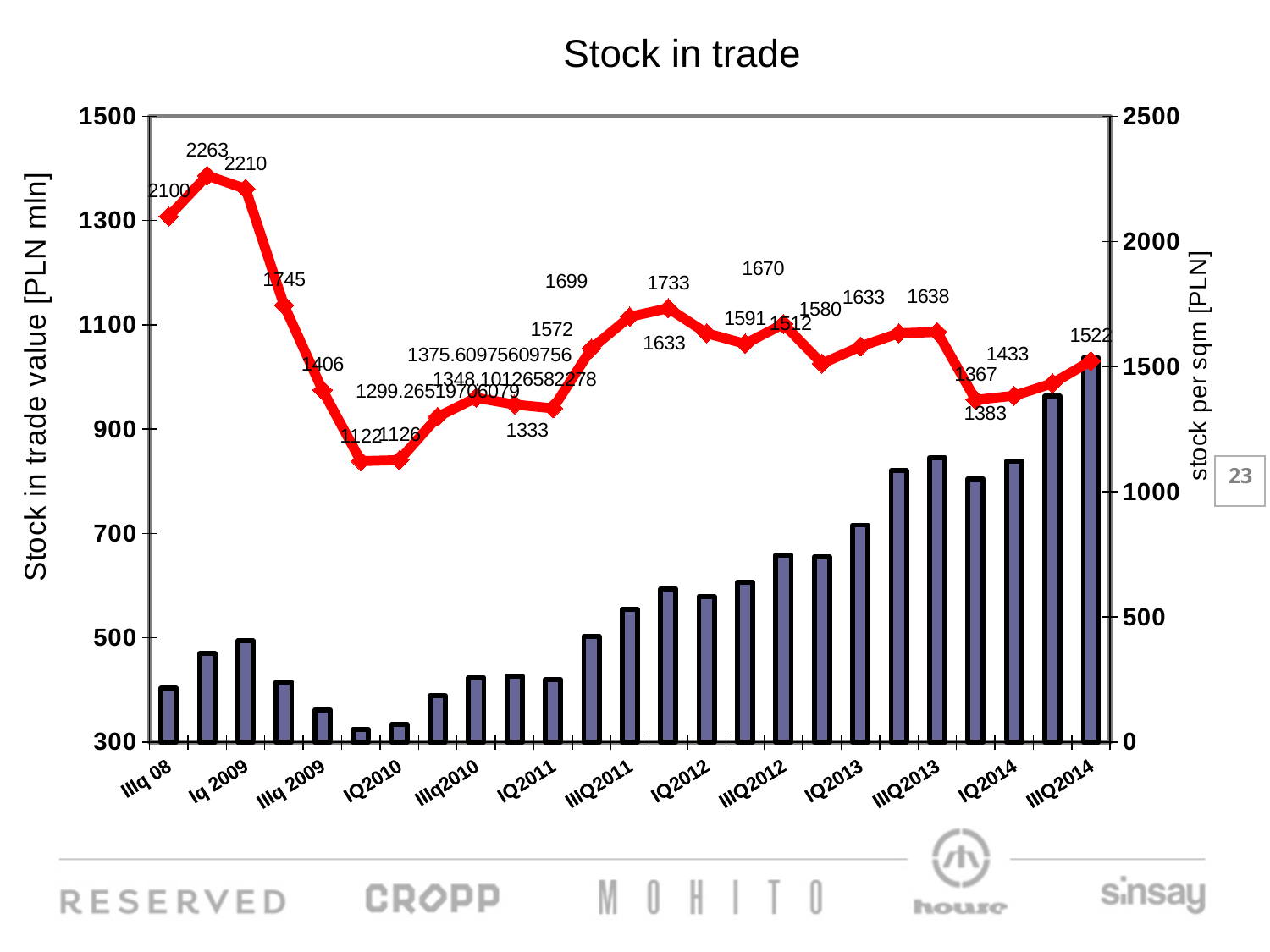
What is the title of the right-hand vertical axis? stock per sqm [PLN] Is the stock in trade value bar for IQ2010 greater or less than 500? less What is the stock per sqm value shown for IIIq 08? 2100 How many bars are plotted in the chart? 25 What is the highest stock per sqm value labelled on the line? 2263 What is the difference between the stock per sqm values for Iq 2009 (2210) and IIIq 08 (2100)? 110 Is the stock in trade value bar for IIIQ2014 greater or less than 900? greater Which has the higher stock per sqm value, IIIQ2011 or IQ2012? IIIQ2011 What is the stock per sqm value shown for IIIQ2011? 1699 What is the stock per sqm value shown for IIIQ2014? 1522 What kind of chart is shown on the slide? Combined bar and line chart What is the lowest stock per sqm value labelled on the line? 1122